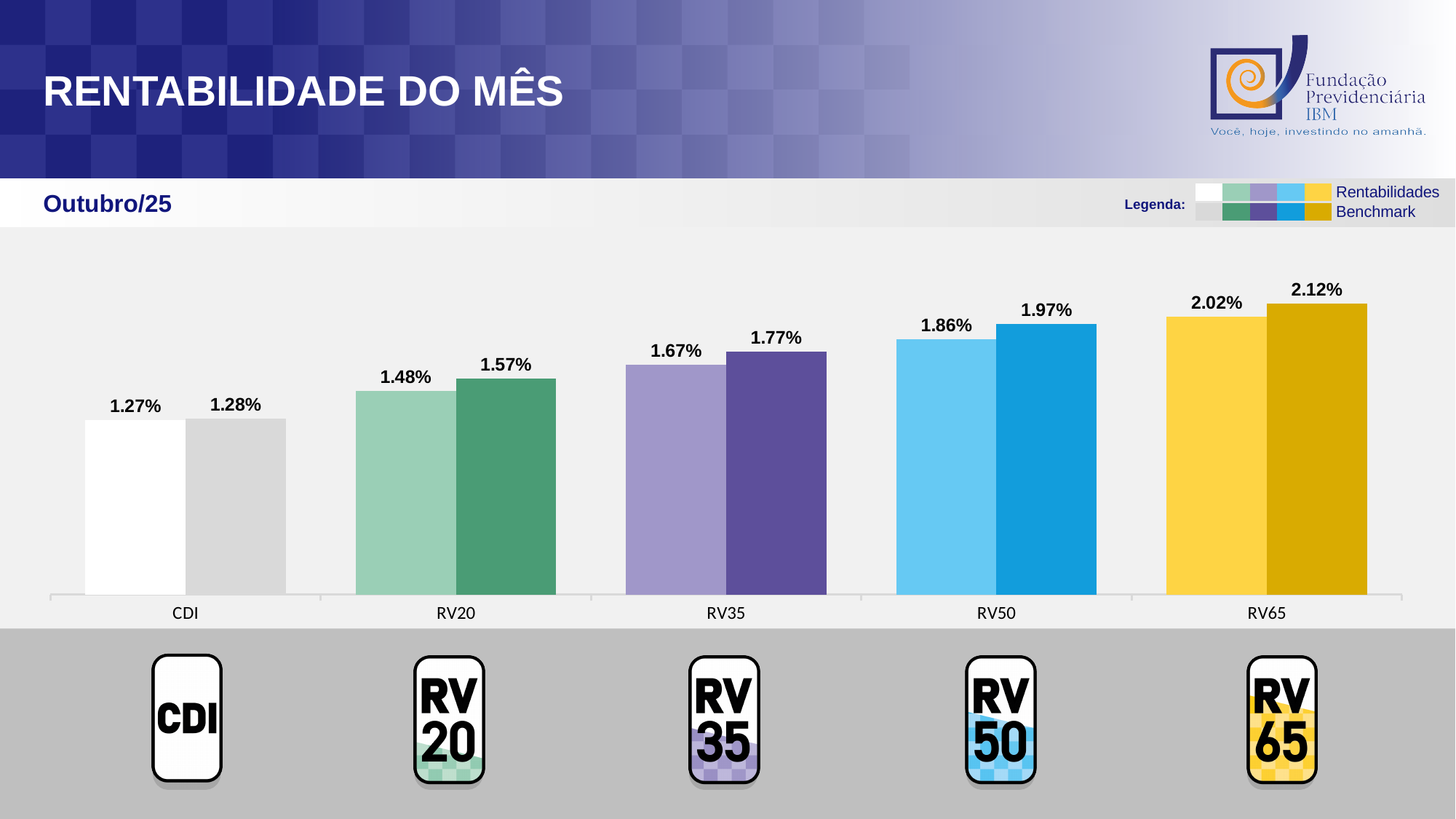
How many categories are shown on the x axis of the chart? 5 Which category has the lowest Rentabilidades value? CDI Which is larger for RV35: the Rentabilidades value or the Benchmark value? Benchmark Which category has the highest Benchmark value? RV65 What is the difference between the Rentabilidades values for RV65 and RV50? 0.16% What is the Rentabilidades value for CDI? 1.27% What is the difference between the Benchmark and Rentabilidades values for RV20? 0.09% What is the Rentabilidades value for RV35? 1.67% What kind of chart is shown on the slide? Bar chart Do the Rentabilidades values rise or fall from CDI to RV65 along the x axis? Rise How many series does the legend list? 2 What is the Benchmark value for RV50? 1.97%